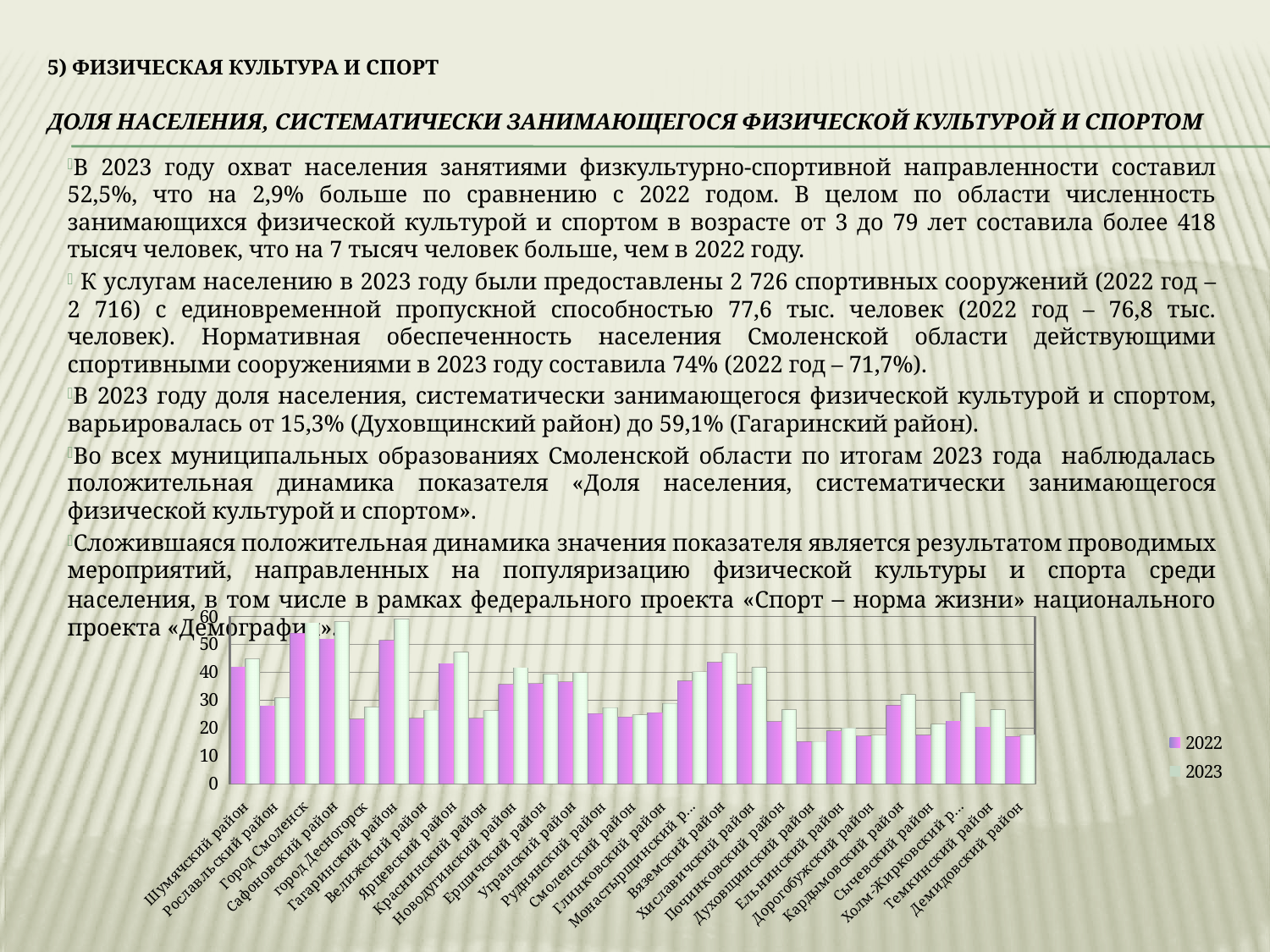
Which has the larger 2022 value, город Смоленск or город Десногорск? город Смоленск Which has the larger 2023 value, Шумячский район or Рославльский район? Шумячский район Is the 2023 value for Гагаринский район greater or less than 50? greater How many series does the chart legend list? 2 Is the 2022 value for город Десногорск greater or less than 30? less Is the 2022 value for Ершичский район greater or less than 30? greater What kind of chart is shown on the slide? bar chart For each municipality, is the 2023 bar higher or lower than the 2022 bar? higher How many municipalities (categories) are shown on the x axis of the chart? 27 Which years are listed in the chart legend? 2022 and 2023